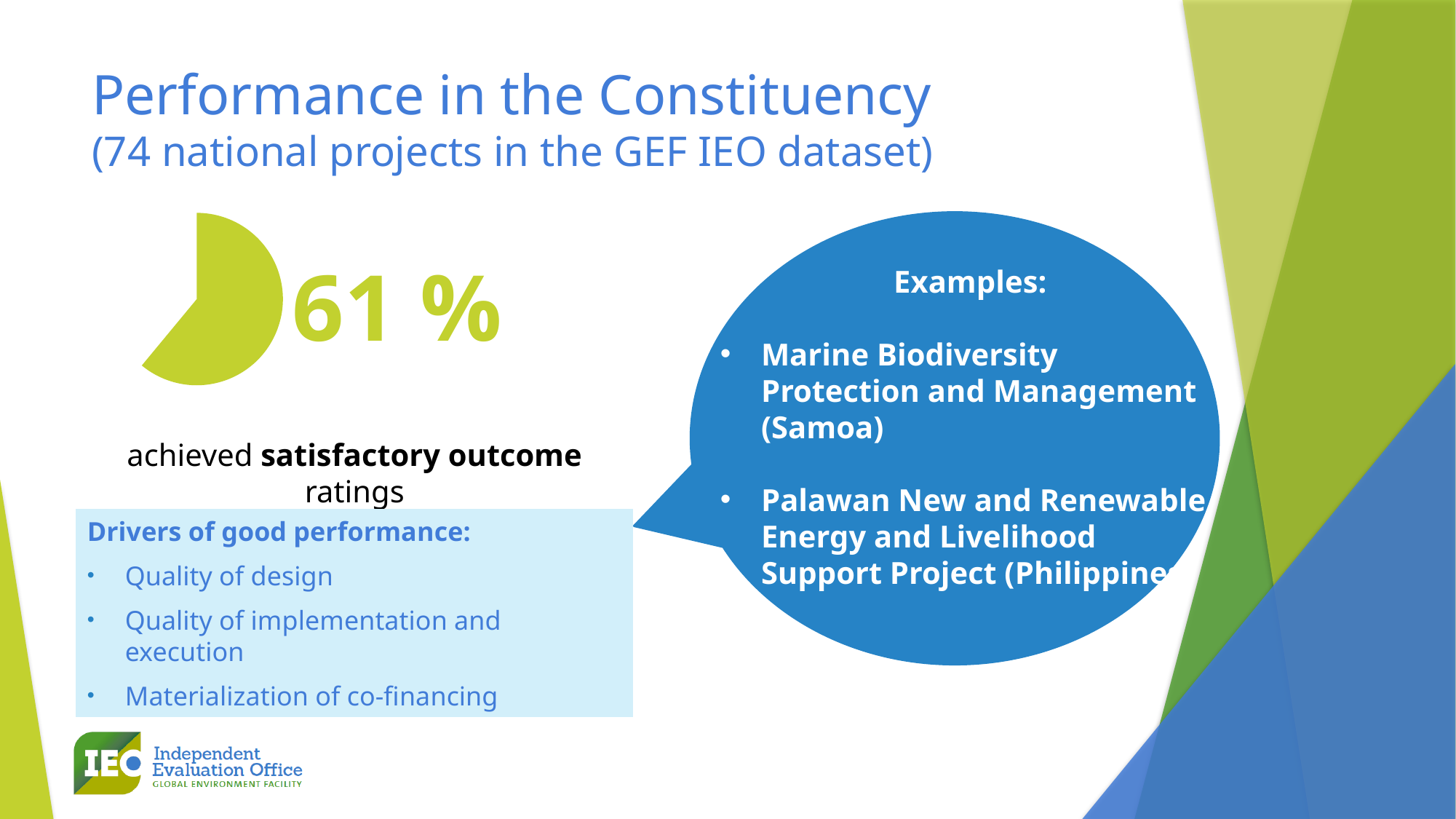
How many national projects are in the GEF IEO dataset shown on the slide? 74 What kind of chart is used to show the share of projects with satisfactory outcome ratings? pie chart What colour is the slice of the pie chart that represents the 61 %? green Is the share of projects with satisfactory outcome ratings greater or less than 75%? less Is the share of projects with satisfactory outcome ratings greater or less than 50%? greater What does the 61 % figure next to the pie chart represent? projects that achieved satisfactory outcome ratings What percentage of the 74 national projects achieved satisfactory outcome ratings according to the chart? 61 % What share of the pie does the green slice represent? 61 %